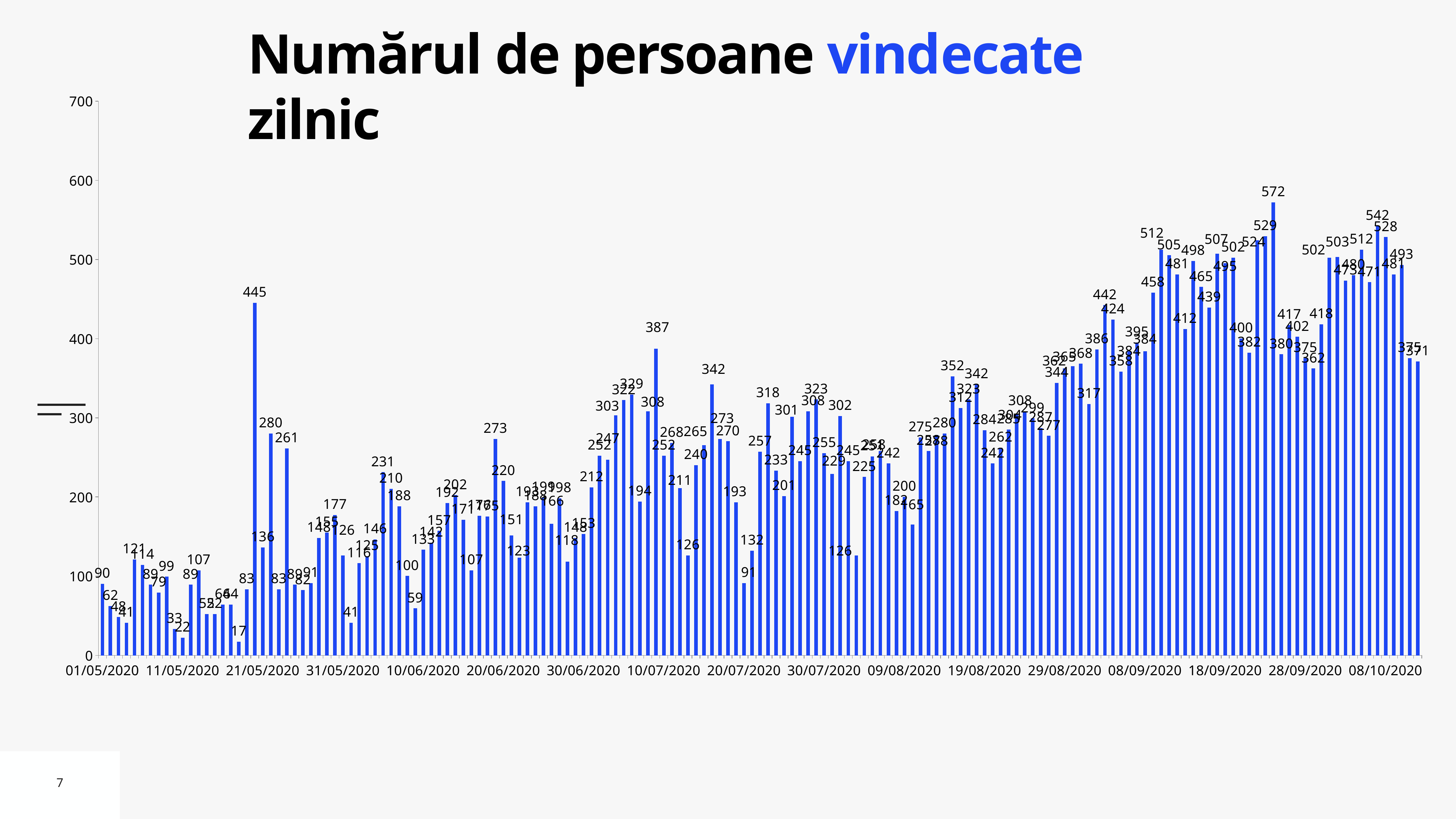
Overall, do the daily values rise or fall from May to October 2020? rise What is the lowest daily value shown in the chart? 17 What is the title of the chart? Numărul de persoane vindecate zilnic What is the value for 21/05/2020? 136 Is the value for 01/05/2020 greater or less than 100? less What is the highest daily value shown in the chart? 572 What is the maximum value shown on the vertical axis? 700 Is the value for the last bar in the chart greater or less than 300? greater What type of chart is shown on the slide? bar chart What is the value for the first bar, 01/05/2020? 90